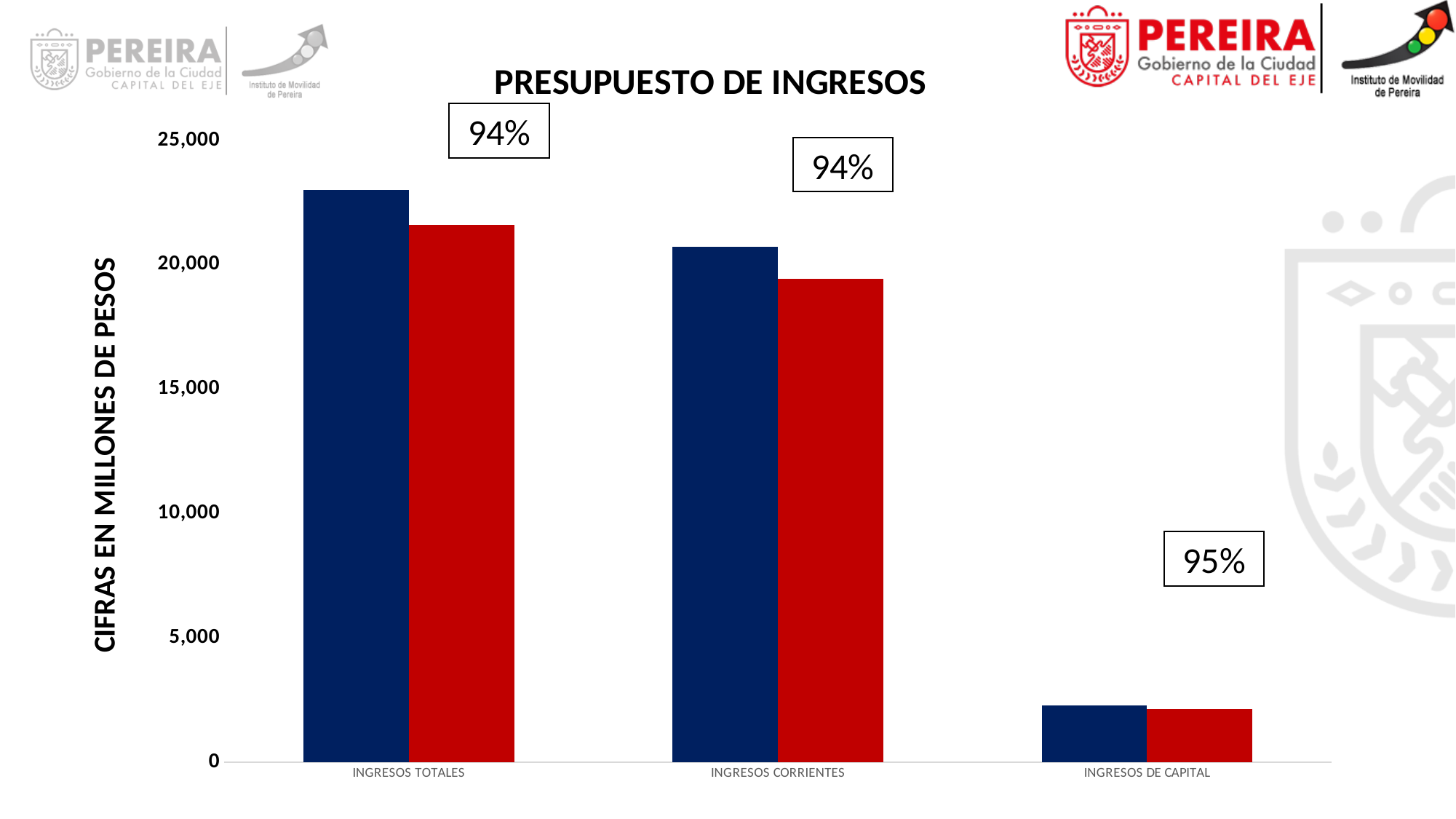
What percentage is shown in the box above the INGRESOS CORRIENTES bars? 94% Is the value of the blue bar for INGRESOS TOTALES greater or less than 20,000? greater What is the title of the chart? PRESUPUESTO DE INGRESOS For INGRESOS TOTALES, is the blue bar or the red bar taller? blue bar Is the value of the red bar for INGRESOS CORRIENTES greater or less than 15,000? greater Which category has the shortest bars in the chart? INGRESOS DE CAPITAL What percentage is shown in the box above the INGRESOS DE CAPITAL bars? 95% Which category has the tallest bars in the chart? INGRESOS TOTALES How many categories are shown on the x axis of the chart? 3 What kind of chart is shown on the slide? bar chart Is the value of the blue bar for INGRESOS DE CAPITAL greater or less than 5,000? less What is the label on the vertical axis of the chart? CIFRAS EN MILLONES DE PESOS